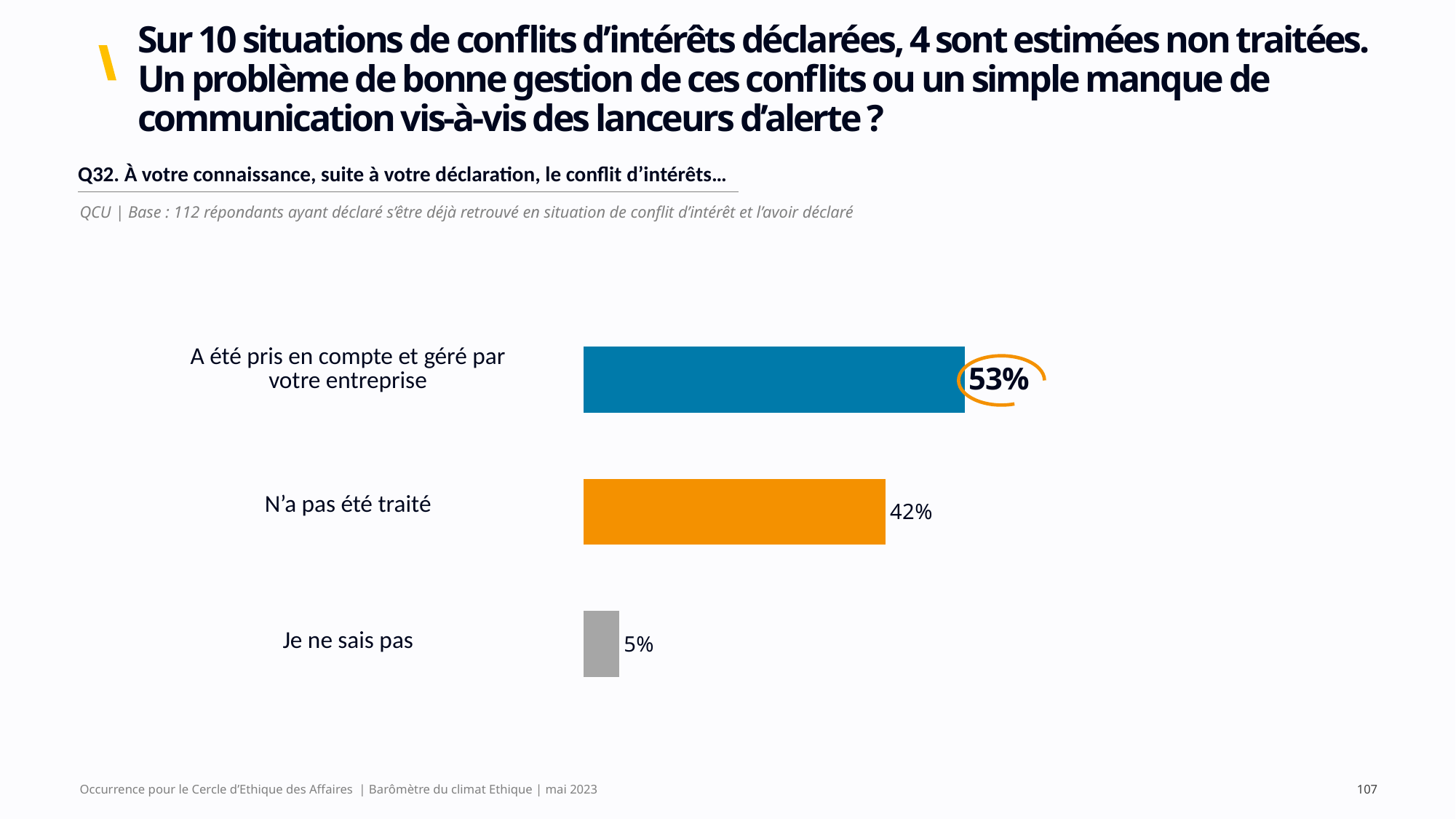
Which category has the lowest value in the chart? Je ne sais pas What is the difference between the values for 'N'a pas été traité' and 'Je ne sais pas'? 37 percentage points What percentage of respondents said the conflict of interest 'A été pris en compte et géré par votre entreprise'? 53% Which category has the highest value in the chart? A été pris en compte et géré par votre entreprise What is the total of the three values shown in the chart? 100% What is the value shown for 'Je ne sais pas'? 5% What is the value shown for 'N'a pas été traité'? 42% What is the difference between the values for 'A été pris en compte et géré par votre entreprise' and 'N'a pas été traité'? 11 percentage points How many categories are shown in the chart? 3 Which is larger: the value for 'N'a pas été traité' or the value for 'Je ne sais pas'? N'a pas été traité What kind of chart is shown on the slide? Bar chart Which value on the chart is circled in orange? 53%